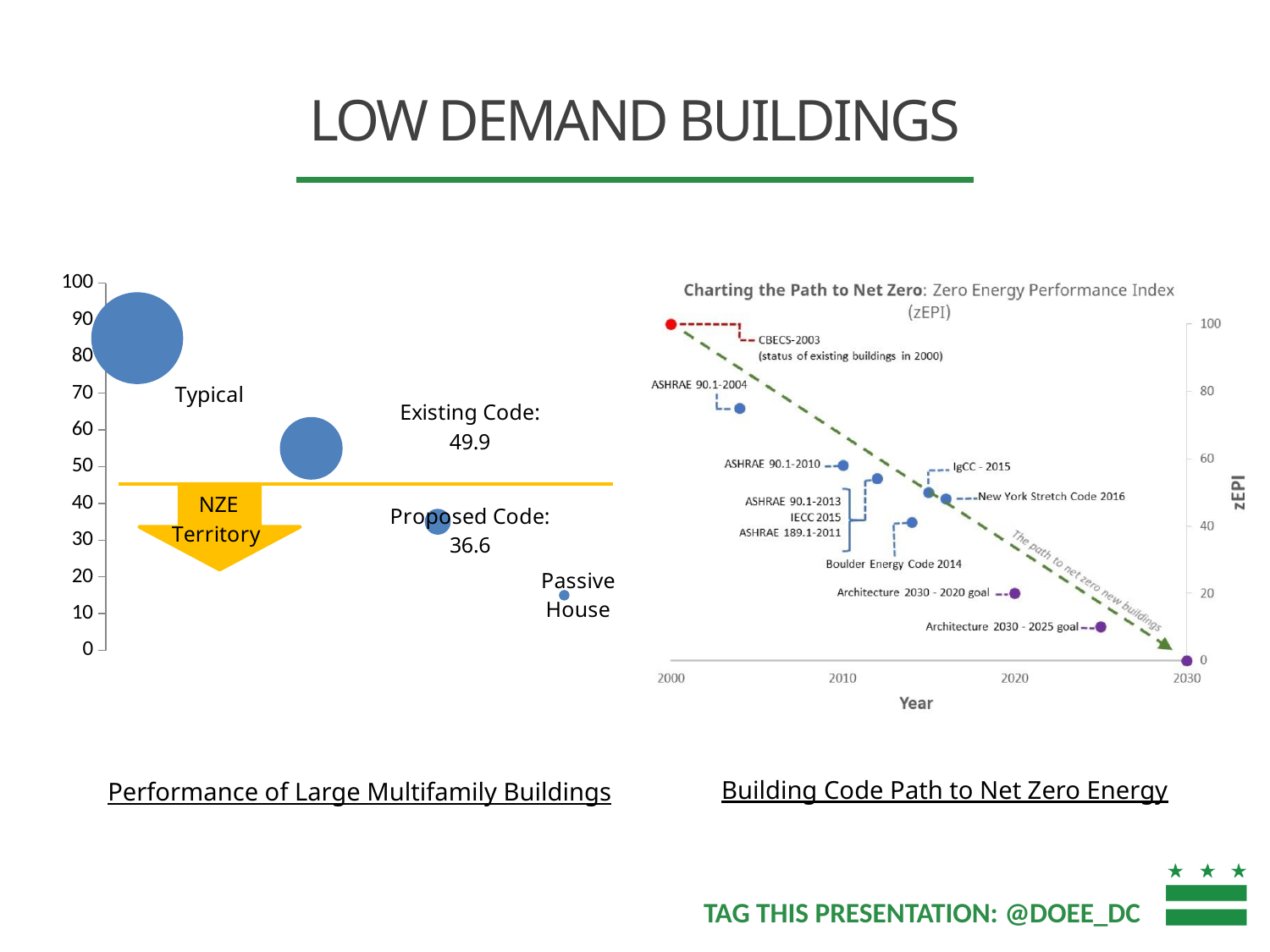
On the Charting the Path to Net Zero chart, is the zEPI value for Boulder Energy Code 2014 greater or less than 60? less On the Performance of Large Multifamily Buildings chart, what is the value for Existing Code? 49.9 On the Performance of Large Multifamily Buildings chart, is the value for Passive House greater or less than 30? less On the Charting the Path to Net Zero chart, do the zEPI values rise or fall as the year increases along the x axis? fall On the Performance of Large Multifamily Buildings chart, what is the difference between the Existing Code and Proposed Code values? 13.3 On the Performance of Large Multifamily Buildings chart, how many labeled building categories are plotted? 4 On the Performance of Large Multifamily Buildings chart, which category has the lowest value? Passive House On the Performance of Large Multifamily Buildings chart, what is the value for Proposed Code? 36.6 On the Performance of Large Multifamily Buildings chart, which category has the highest value? Typical On the Performance of Large Multifamily Buildings chart, what label is shown on the yellow arrow below the horizontal line? NZE Territory On the Performance of Large Multifamily Buildings chart, which is larger, Existing Code or Proposed Code? Existing Code On the Performance of Large Multifamily Buildings chart, is the value for Typical greater or less than 70? greater